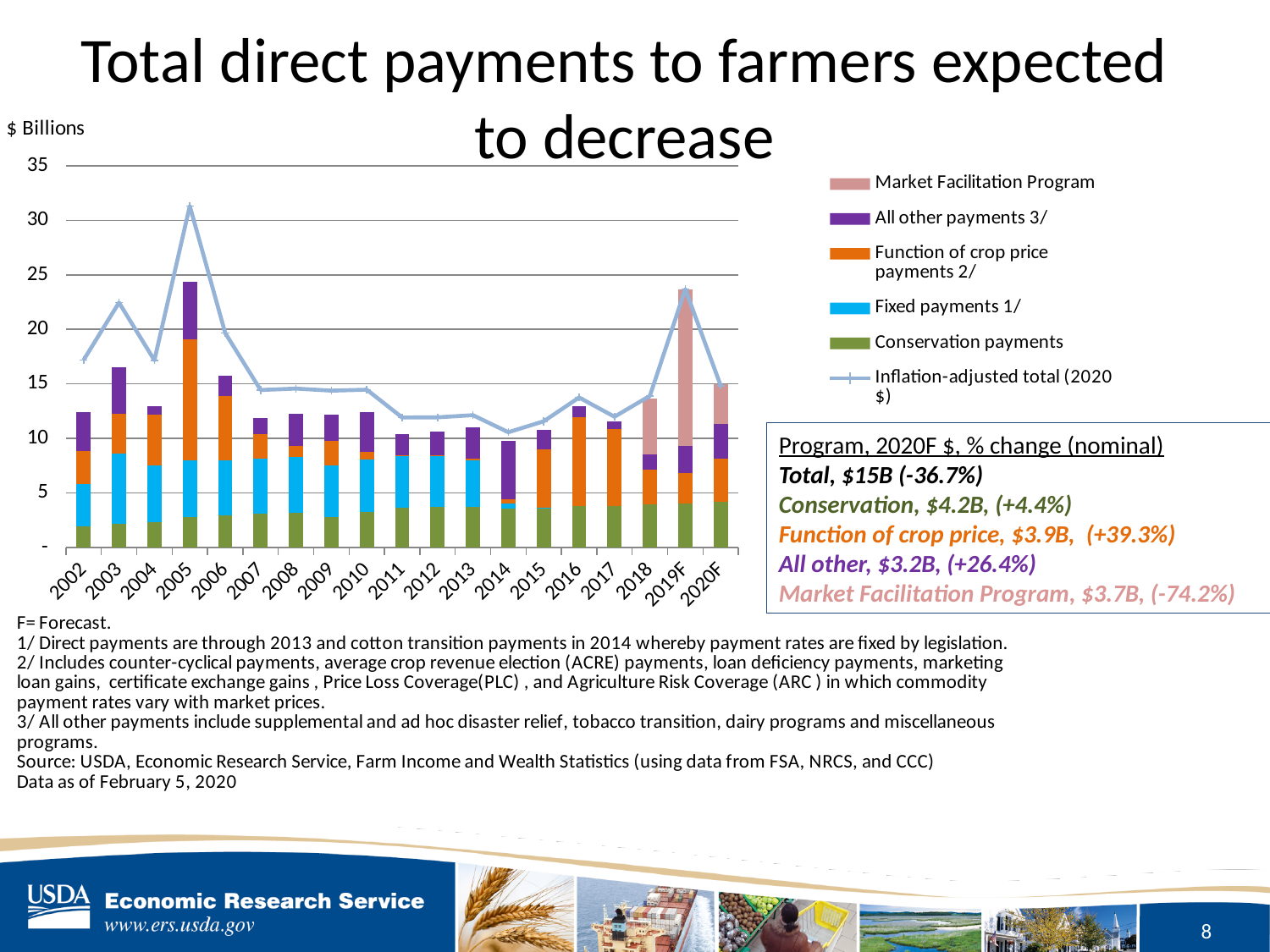
Which year has the highest inflation-adjusted total? 2005 According to the slide, what is the Conservation payments value for 2020F? $4.2B Is the total stacked bar for 2011 greater or less than 15? less How many years are shown along the x axis of the chart? 19 Which year has a taller stacked bar, 2019F or 2020F? 2019F What kind of chart is shown on the slide? combination bar and line chart (stacked bars with a line) Does the inflation-adjusted total rise or fall from 2005 to 2011? fall How many series does the chart legend list? 6 Is the inflation-adjusted total for 2005 greater or less than 30? greater Is the total stacked bar for 2019F greater or less than 20? greater According to the slide, what is the total direct payments value for 2020F? $15B Which series is plotted as a line rather than as stacked bars? Inflation-adjusted total (2020 $)